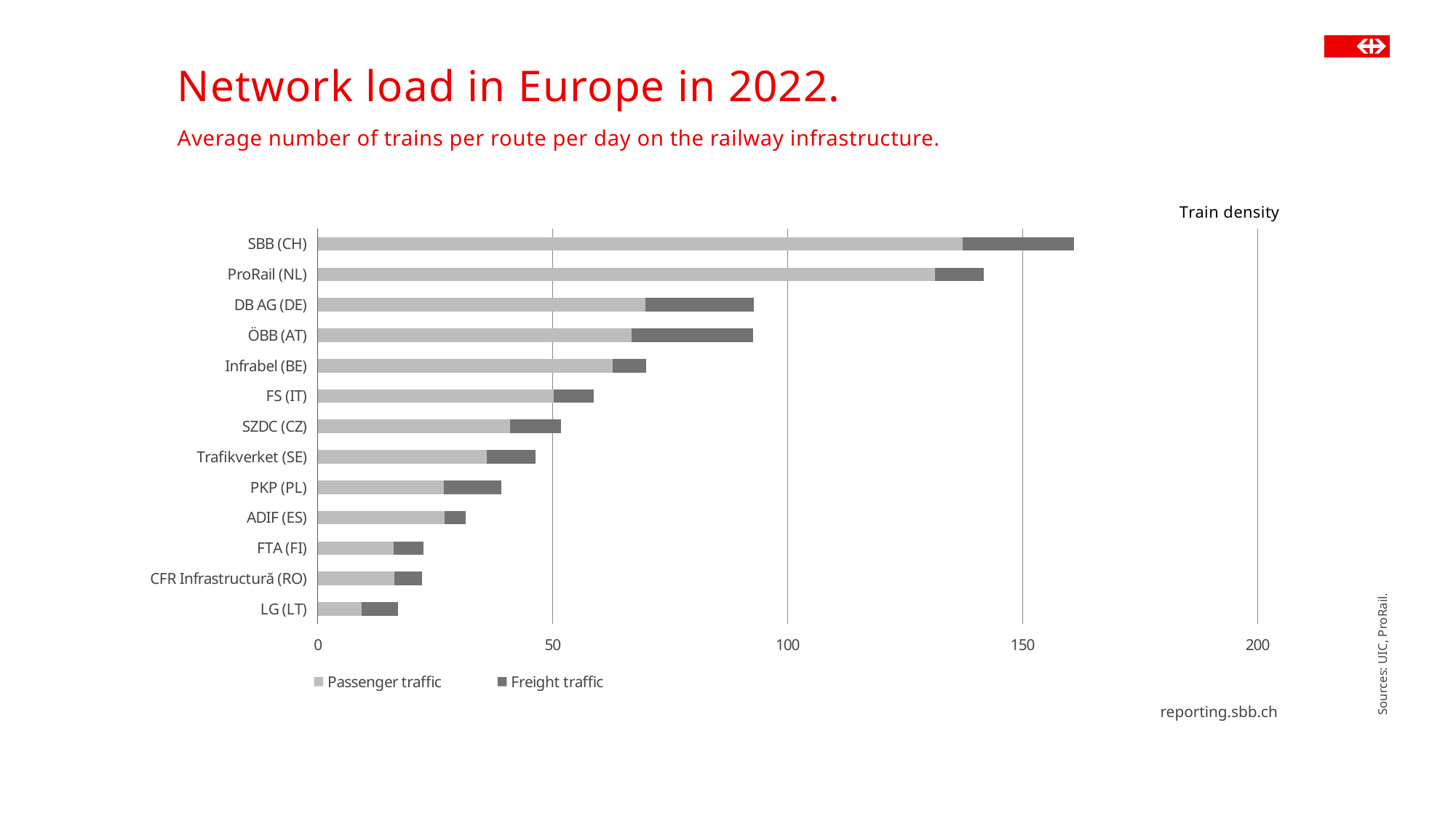
Is the total value for SBB (CH) greater or less than 150? greater Which operator has the highest total train density? SBB (CH) Is the total value for DB AG (DE) greater or less than 100? less What kind of chart is shown on the slide? Stacked bar chart How many series does the legend list? 2 Which has a larger total train density, Infrabel (BE) or FS (IT)? Infrabel (BE) Which operator has the lowest total train density? LG (LT) How many railway infrastructure operators are listed on the chart? 13 Is the total value for PKP (PL) greater or less than 50? less What are the two series named in the legend? Passenger traffic and Freight traffic Which has a larger total train density, SBB (CH) or DB AG (DE)? SBB (CH)